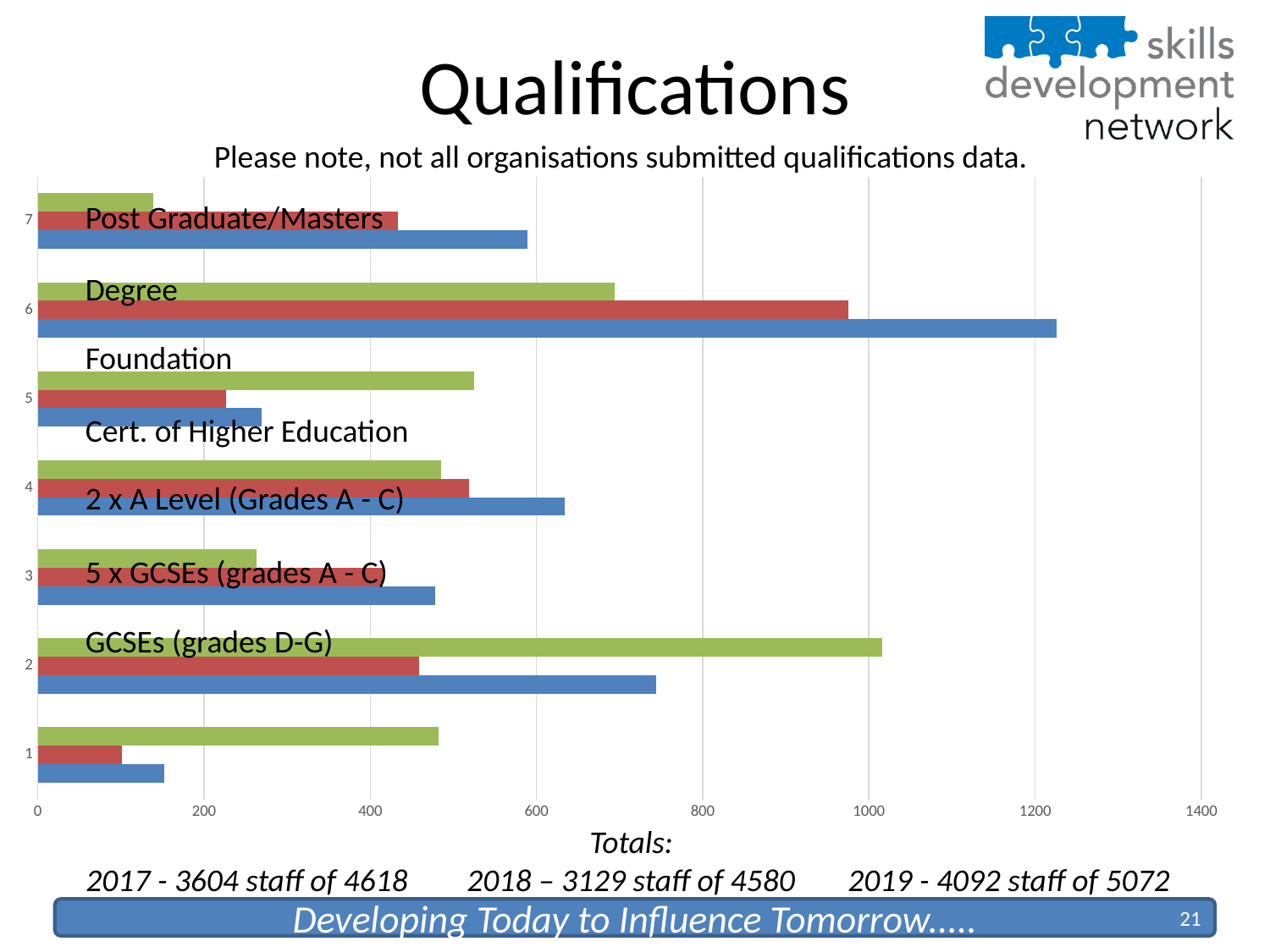
How many numbered categories are shown on the vertical axis of the chart? 7 Is the blue bar for category 7 greater or less than 400? greater Is the blue bar for category 6 greater or less than 1200? greater Which numbered category has the shortest red bar? 1 What kind of chart is shown on the slide? bar chart Is the green bar for category 2 greater or less than 800? greater Which numbered category has the longest green bar? 2 How many bars are plotted for each numbered category? 3 What is the title of the slide containing the chart? Qualifications Which numbered category has the longest blue bar? 6 For category 5, which is longer: the green bar or the red bar? green